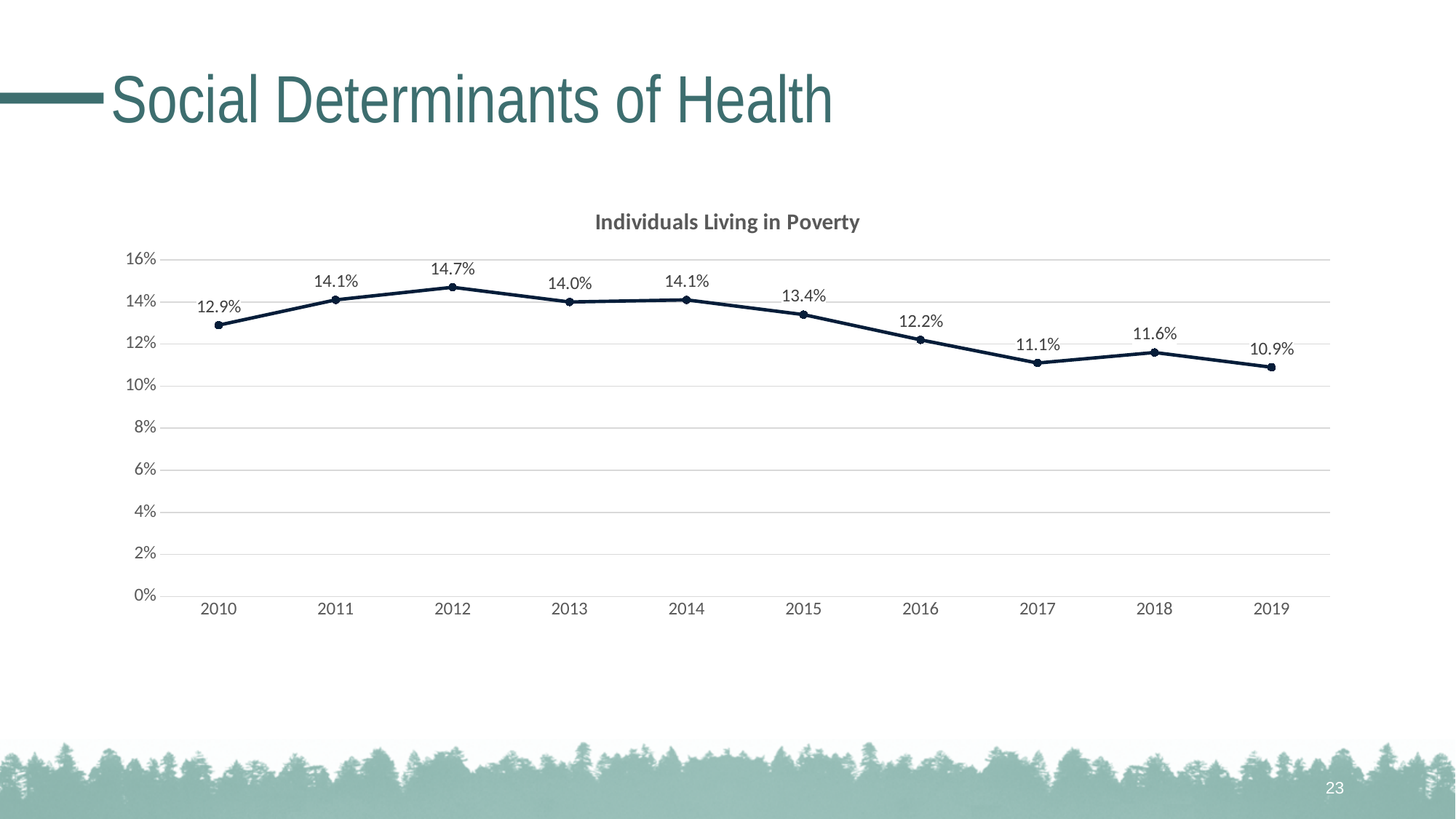
What is the value for 2015? 13.4% What is the value for 2012? 14.7% What is the title of the chart? Individuals Living in Poverty Which year has the highest value? 2012 Which year has the lowest value? 2019 What is the difference between the values for 2012 and 2019? 3.8% Which is larger, the value for 2017 or the value for 2018? 2018 Is the value for 2016 greater or less than 14%? less How many years are plotted on the chart? 10 What kind of chart is shown? line chart Do the values generally rise or fall from 2014 to 2019? fall What is the value for 2019? 10.9%